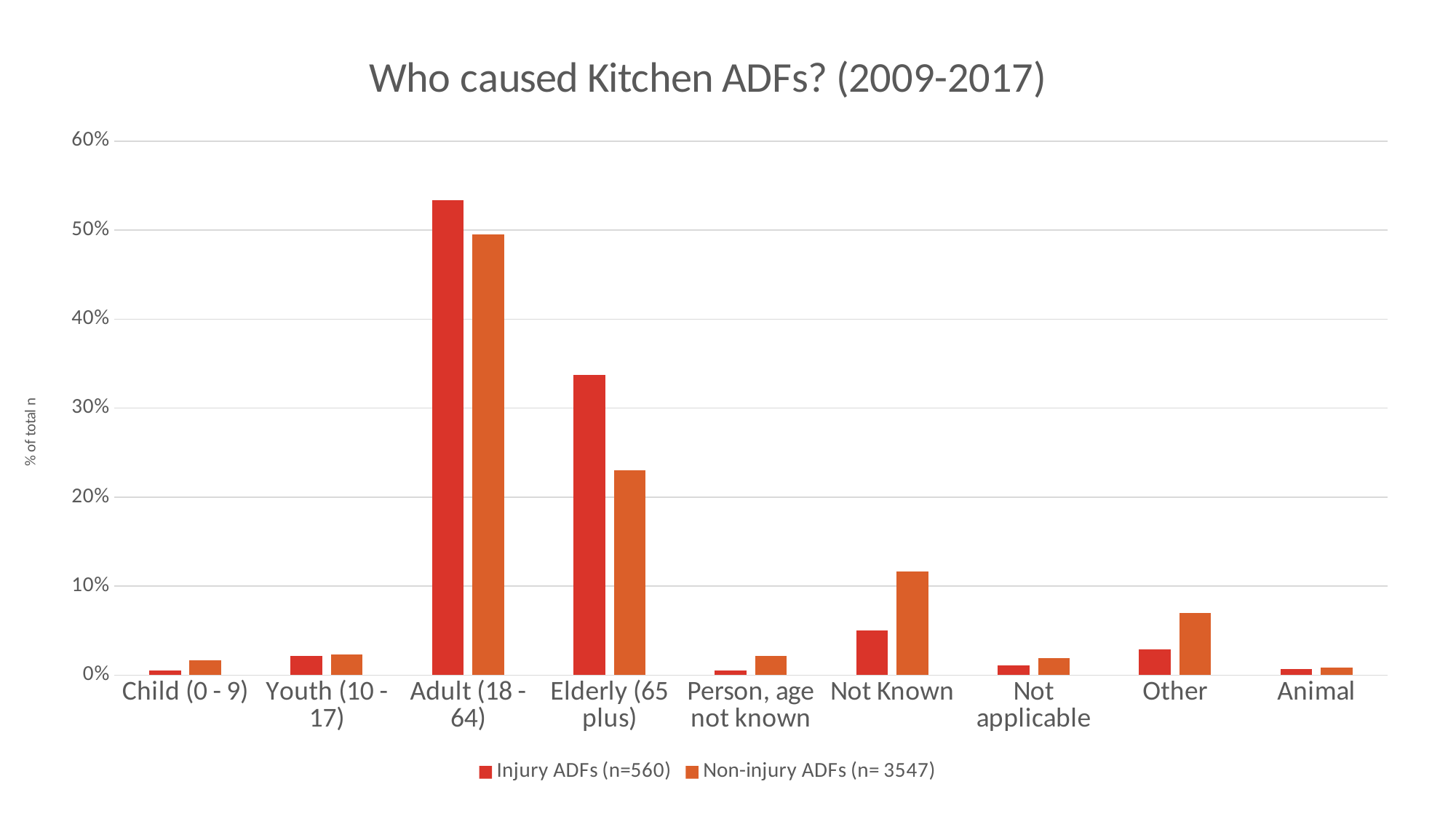
For Elderly (65 plus), which series has the larger value, Injury ADFs or Non-injury ADFs? Injury ADFs Which category has the highest value for Injury ADFs (n=560)? Adult (18 - 64) What is the title of the chart? Who caused Kitchen ADFs? (2009-2017) Which category has the highest value for Non-injury ADFs (n= 3547)? Adult (18 - 64) Which category has the lowest value for Non-injury ADFs (n= 3547)? Animal How many categories are shown on the x axis? 9 Is the Non-injury ADFs value for Other greater or less than 10%? less Is the Injury ADFs value for Elderly (65 plus) greater or less than 30%? greater How many series does the legend list? 2 Is the Injury ADFs value for Adult (18 - 64) greater or less than 50%? greater What kind of chart is shown on the slide? bar chart